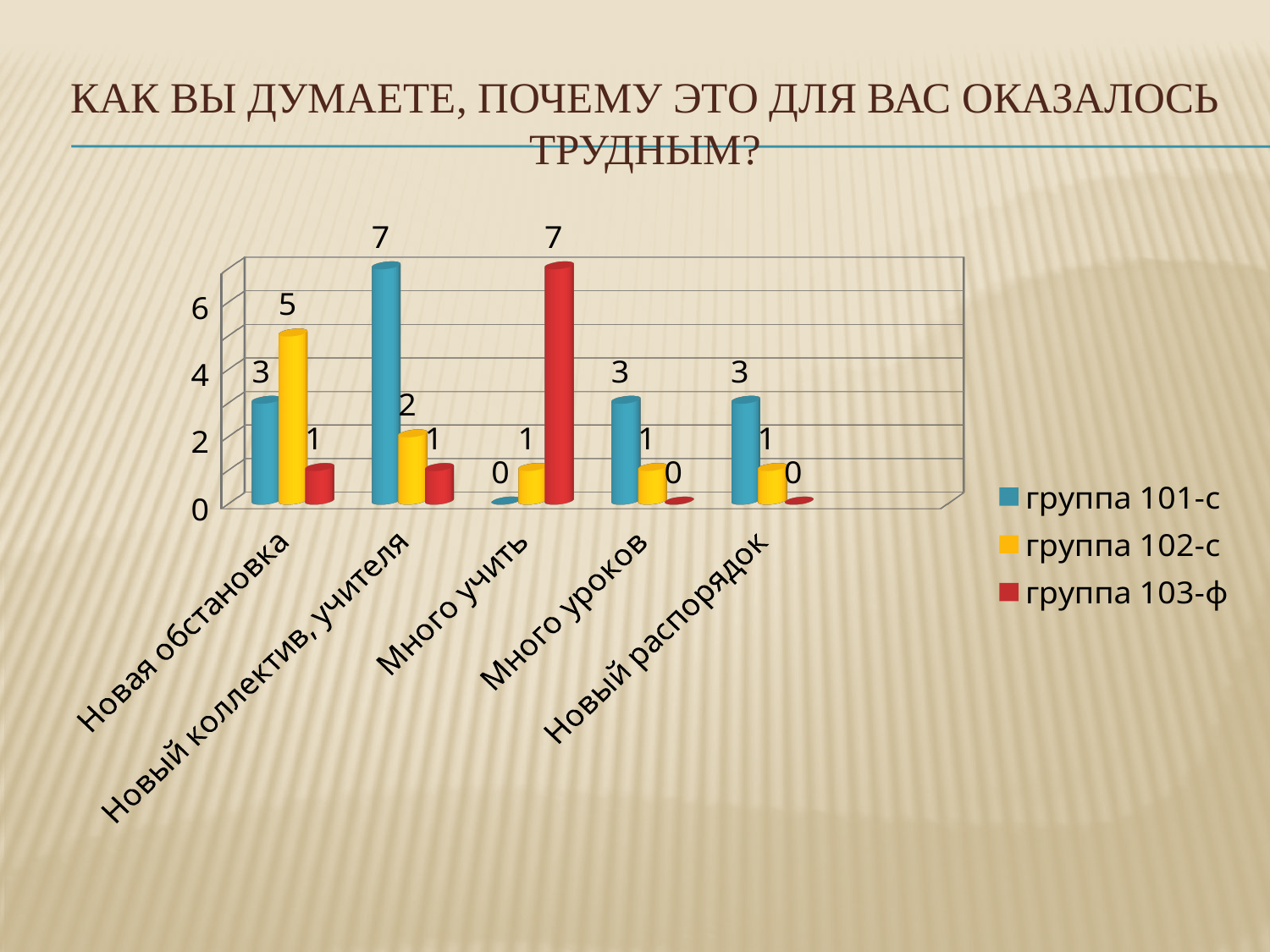
What kind of chart is shown on the slide? bar chart Which is larger in the category Много уроков: the value for группа 101-с or for группа 102-с? группа 101-с What is the value for группа 101-с in the category Новый коллектив, учителя? 7 What is the difference between the values for группа 102-с and группа 103-ф in the category Новая обстановка? 4 How many series does the legend list? 3 Which series is shown in red in the legend? группа 103-ф What is the value for группа 101-с in the category Много учить? 0 In which category does группа 101-с have its highest value? Новый коллектив, учителя What is the value for группа 103-ф in the category Много учить? 7 In which category does группа 102-с have its highest value? Новая обстановка What is the value for группа 102-с in the category Новая обстановка? 5 How many categories are shown on the x axis? 5